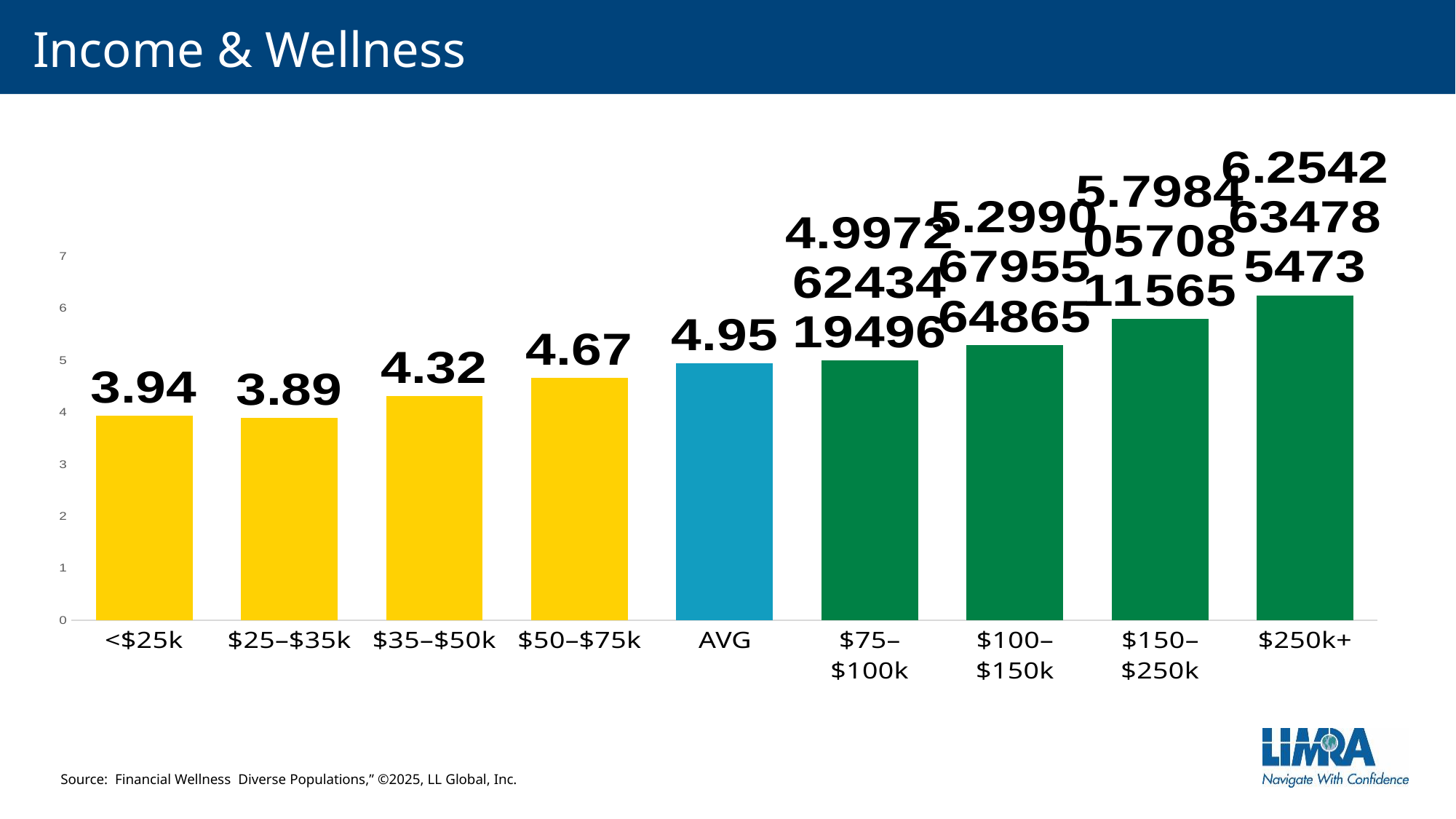
What kind of chart is shown on the slide? bar chart What is the title of the slide? Income & Wellness Which is larger, the value for $35–$50k or the value for $50–$75k? $50–$75k Which category has the lowest value? $25–$35k What is the value for the $25–$35k category? 3.89 Is the value for $250k+ greater or less than 6? greater Which category has the highest value? $250k+ How many bars are shown in the chart? 9 What is the difference between the values for $50–$75k and <$25k? 0.73 What is the value for the <$25k category? 3.94 What is the value for the $35–$50k category? 4.32 What is the value for the AVG bar? 4.95